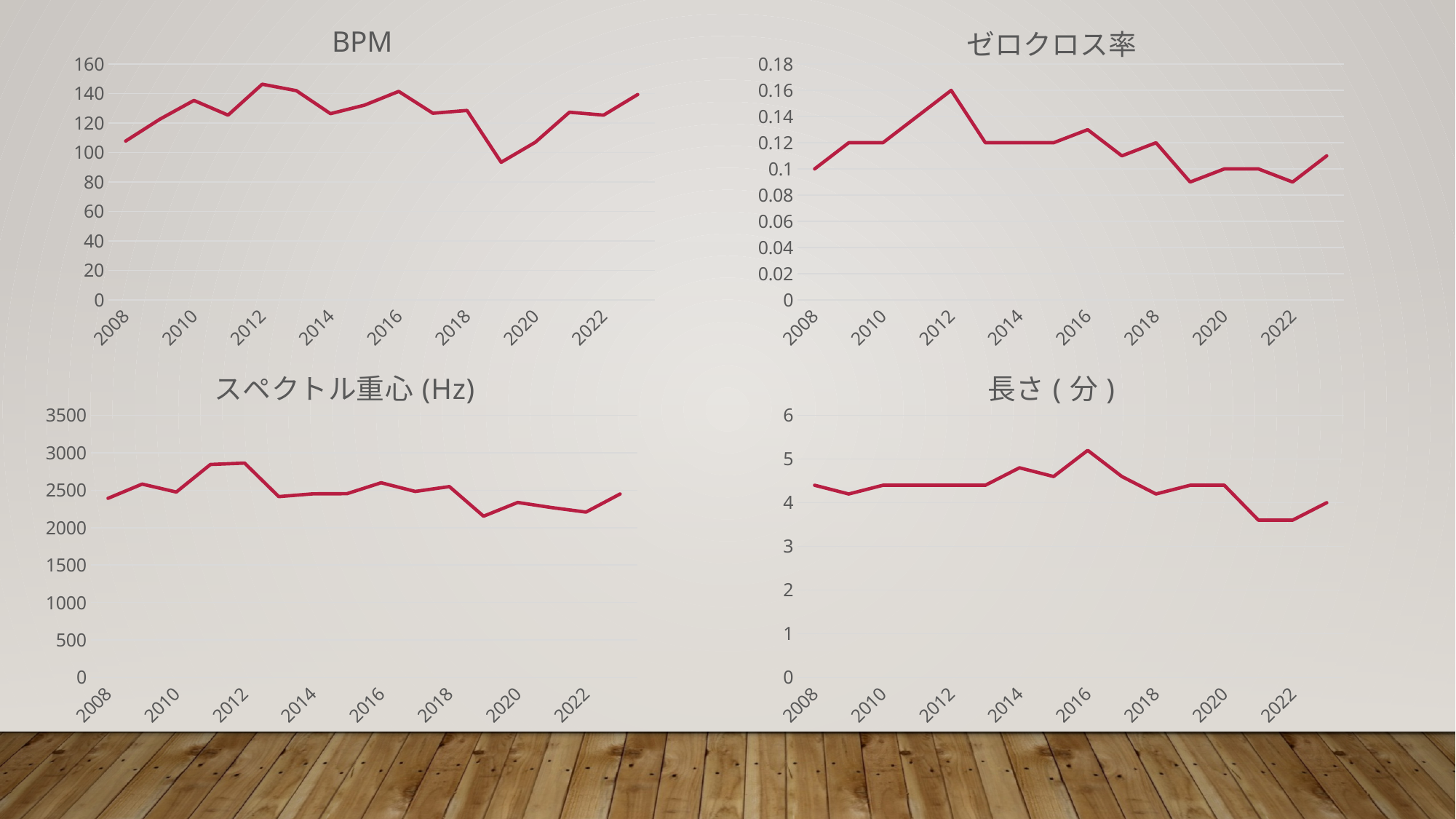
In the BPM chart, is the value for 2019 greater or less than 100? less How many charts are shown on the slide? 4 In the ゼロクロス率 chart, is the value for 2012 greater or less than 0.14? greater In the 長さ ( 分 ) chart, is the value for 2021 greater or less than 4? less In the ゼロクロス率 chart, which year has the highest value? 2012 In the 長さ ( 分 ) chart, which is larger, the value for 2016 or the value for 2021? 2016 What kind of chart is the BPM chart? line chart In the 長さ ( 分 ) chart, which year has the highest value? 2016 In the BPM chart, which year has the lowest value? 2019